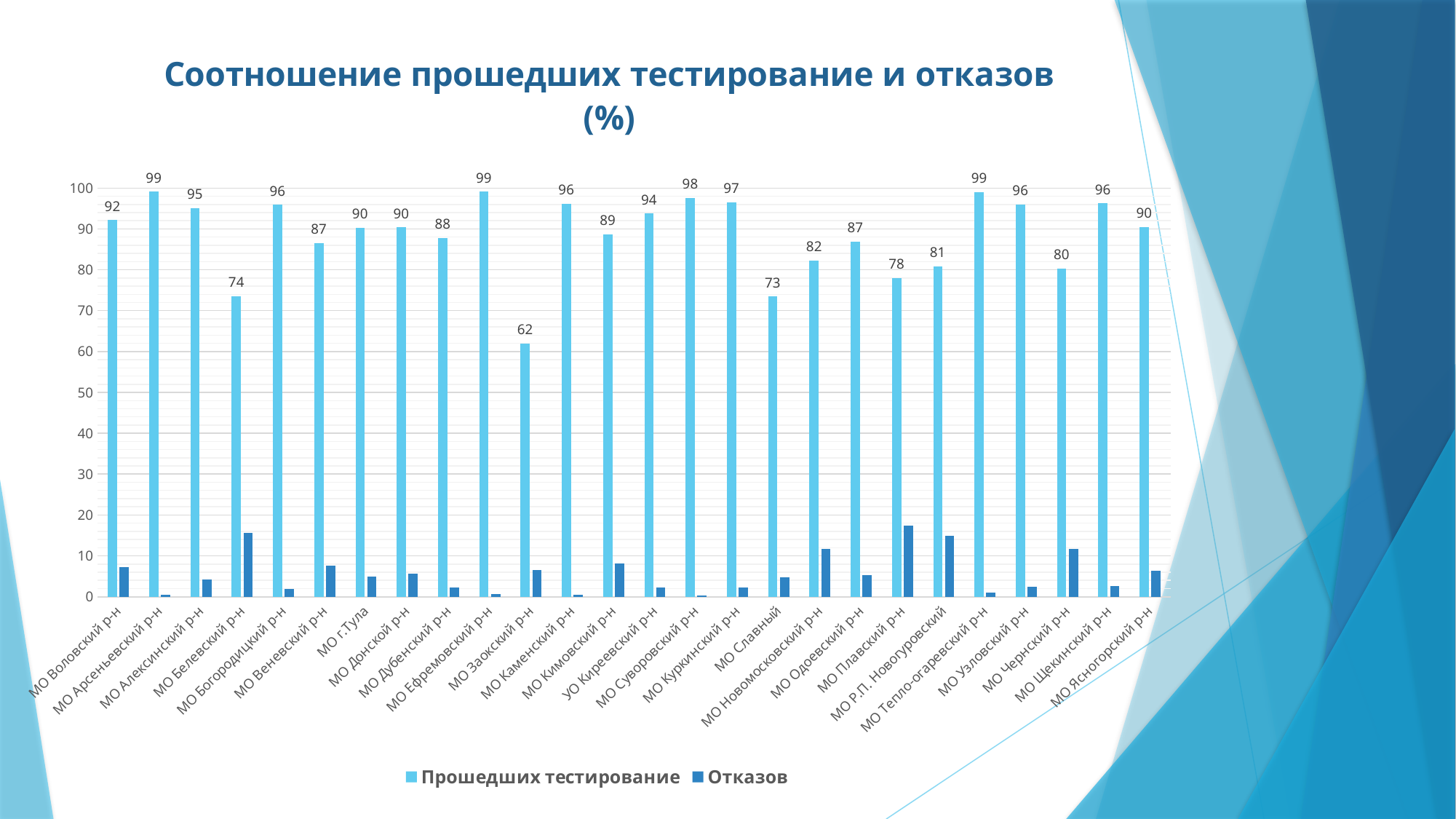
Is the Отказов value for МО Куркинский р-н greater or less than 10? less What is the difference between the Прошедших тестирование values for МО Арсеньевский р-н and МО Заокский р-н? 37 Which has a larger Прошедших тестирование value, МО Славный or МО Чернский р-н? МО Чернский р-н How many series does the legend list? 2 What is the title of the chart? Соотношение прошедших тестирование и отказов (%) What kind of chart is shown on the slide? bar chart What is the value of Прошедших тестирование for МО Новомосковский р-н? 82 Is the Отказов value for МО Белевский р-н greater or less than 10? greater Which category has the lowest value of Прошедших тестирование? МО Заокский р-н What is the value of Прошедших тестирование for МО Заокский р-н? 62 How many categories are shown on the x axis? 26 What is the value of Прошедших тестирование for МО Белевский р-н? 74